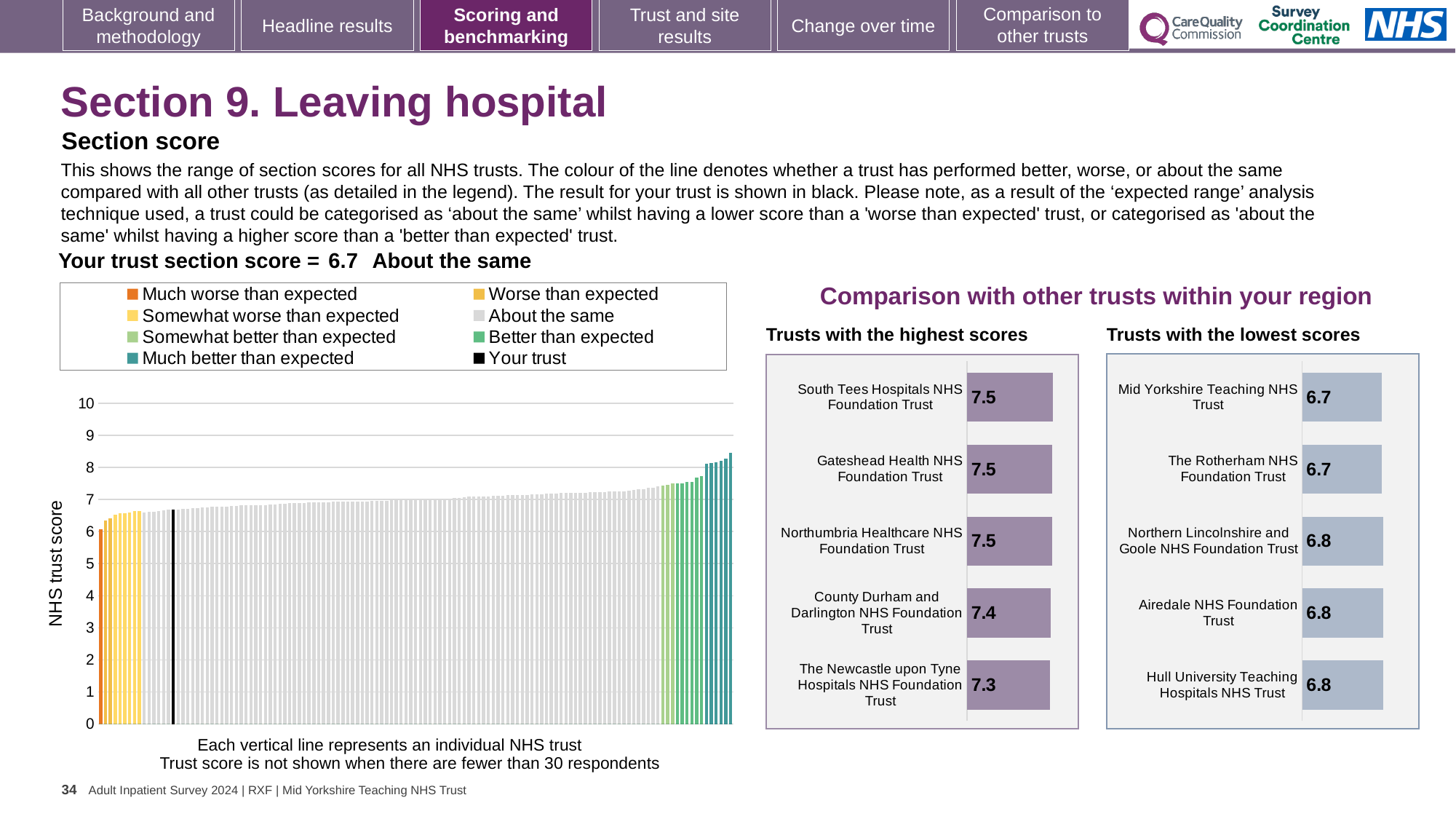
In the large chart on the left, do the trust scores rise or fall moving from left to right along the x axis? rise In the 'Trusts with the highest scores' chart, what is the score for County Durham and Darlington NHS Foundation Trust? 7.4 How many trusts are shown in the 'Trusts with the lowest scores' chart? 5 In the 'Trusts with the highest scores' chart, what is the difference between the scores of South Tees Hospitals NHS Foundation Trust and The Newcastle upon Tyne Hospitals NHS Foundation Trust? 0.2 What is the section score for your trust shown on the slide? 6.7 In the large chart on the left, is the value of the tallest bar at the far right greater or less than 8? greater In the 'Trusts with the highest scores' chart, which trust has the lowest score? The Newcastle upon Tyne Hospitals NHS Foundation Trust In the 'Trusts with the lowest scores' chart, which has the higher score: Airedale NHS Foundation Trust or The Rotherham NHS Foundation Trust? Airedale NHS Foundation Trust In the 'Trusts with the lowest scores' chart, what is the score for Hull University Teaching Hospitals NHS Trust? 6.8 How many entries does the legend above the large chart on the left list? 8 In the large chart on the left, is the value of the shortest bar at the far left greater or less than 7? less What kind of chart is the large chart on the left showing NHS trust scores? bar chart